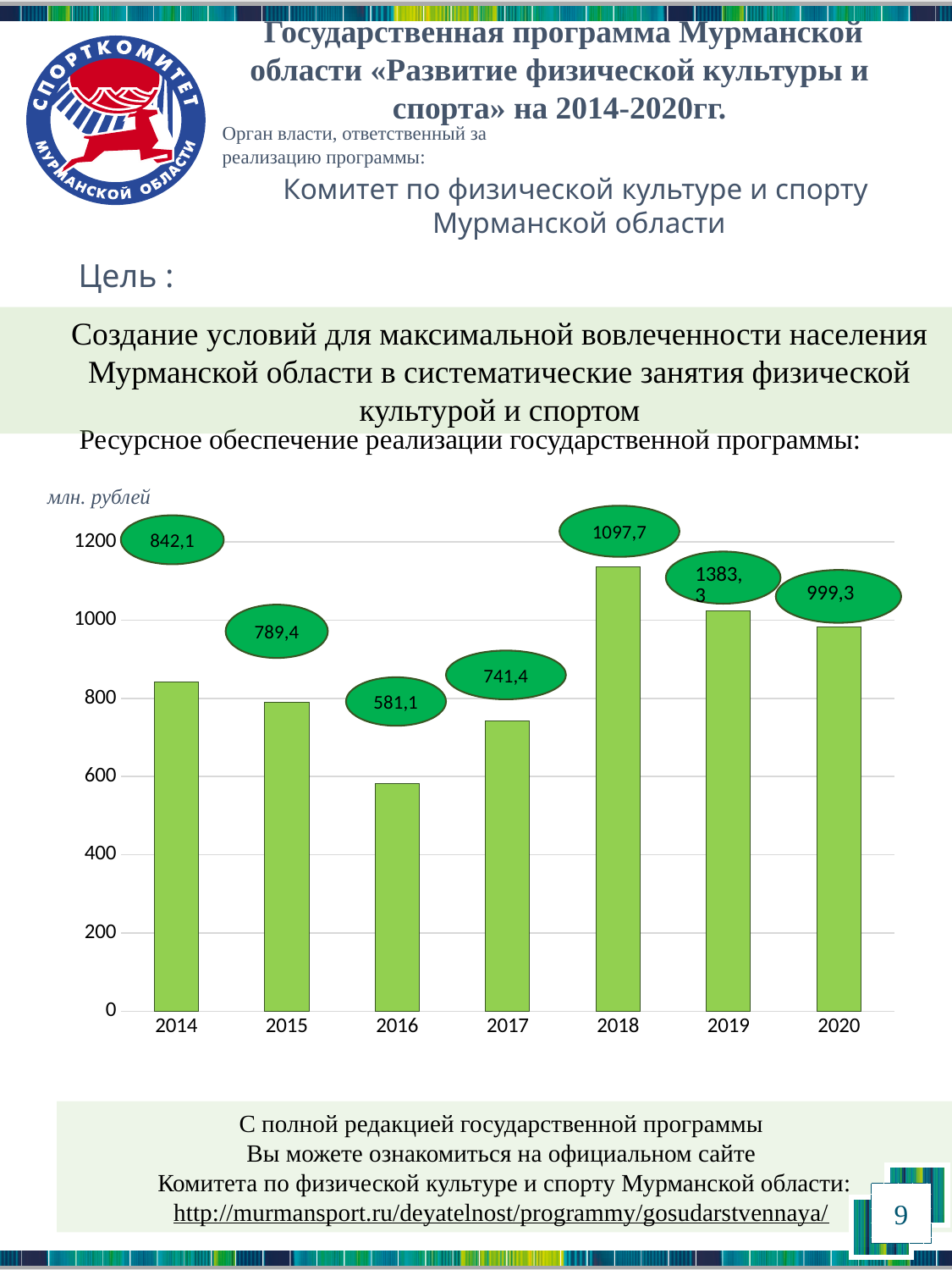
What is the difference between the values for 2014 and 2015? 52,7 Is the value for 2016 greater or less than 600? less What is the value for 2016? 581,1 What is the value for 2014? 842,1 Which year has the lowest value? 2016 Do the values rise or fall from 2014 to 2016? fall What kind of chart is shown on the slide? bar chart How many years are shown on the x axis? 7 Which is larger, the value for 2014 or the value for 2015? 2014